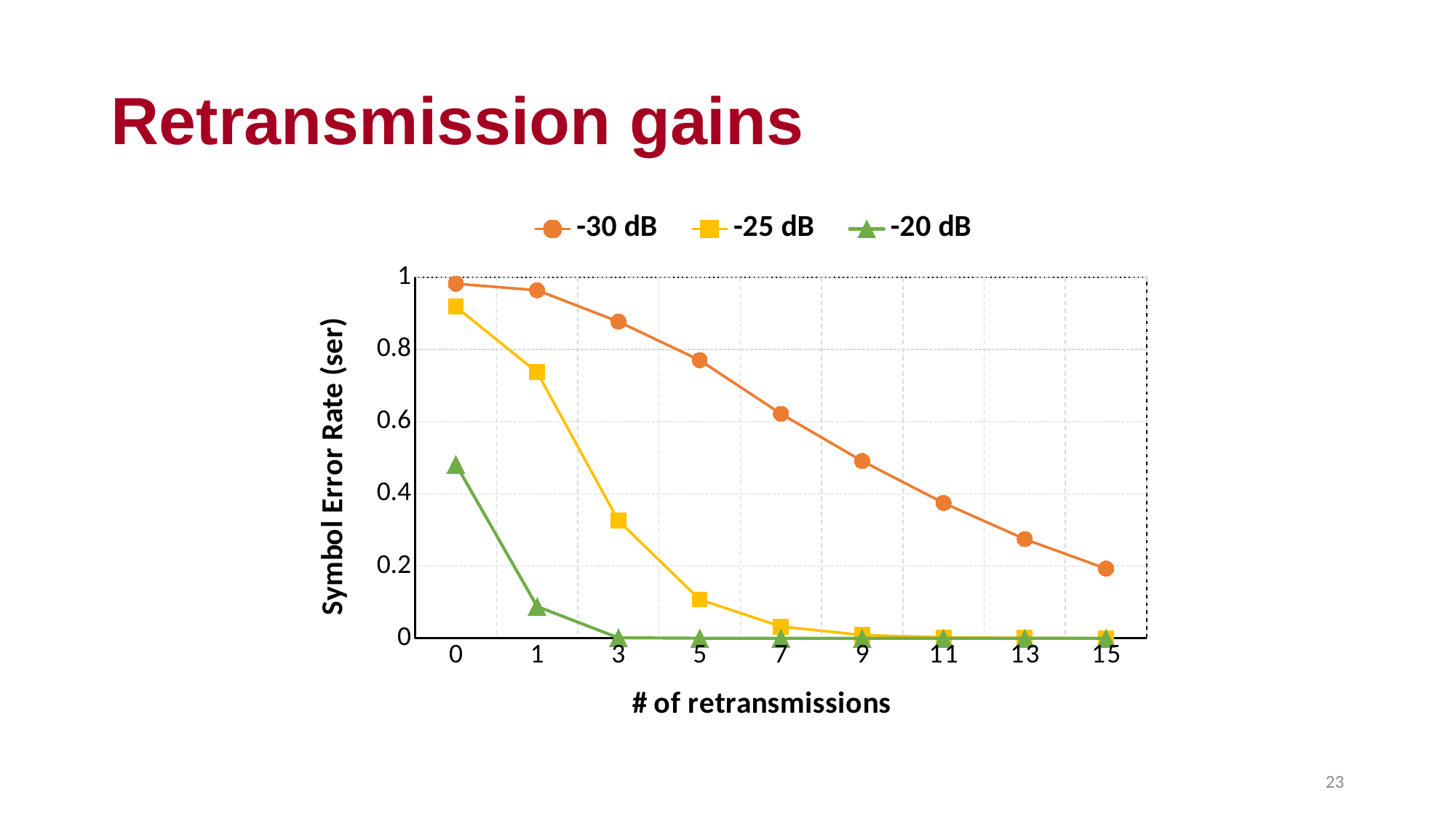
Does the Symbol Error Rate for the -30 dB series rise or fall as the number of retransmissions increases? fall At 0 retransmissions, which series has the lowest Symbol Error Rate? -20 dB What kind of chart is shown on the slide? line chart At 0 retransmissions, which series has the highest Symbol Error Rate? -30 dB Is the Symbol Error Rate for -25 dB at 1 retransmission greater or less than 0.6? greater What is the title of the y axis? Symbol Error Rate (ser) At 5 retransmissions, which series has the higher Symbol Error Rate, -30 dB or -25 dB? -30 dB Is the Symbol Error Rate for -30 dB at 0 retransmissions greater or less than 0.8? greater How many points along the x axis (# of retransmissions) are plotted for each series? 9 Is the Symbol Error Rate for -20 dB at 0 retransmissions greater or less than 0.6? less How many series does the legend list? 3